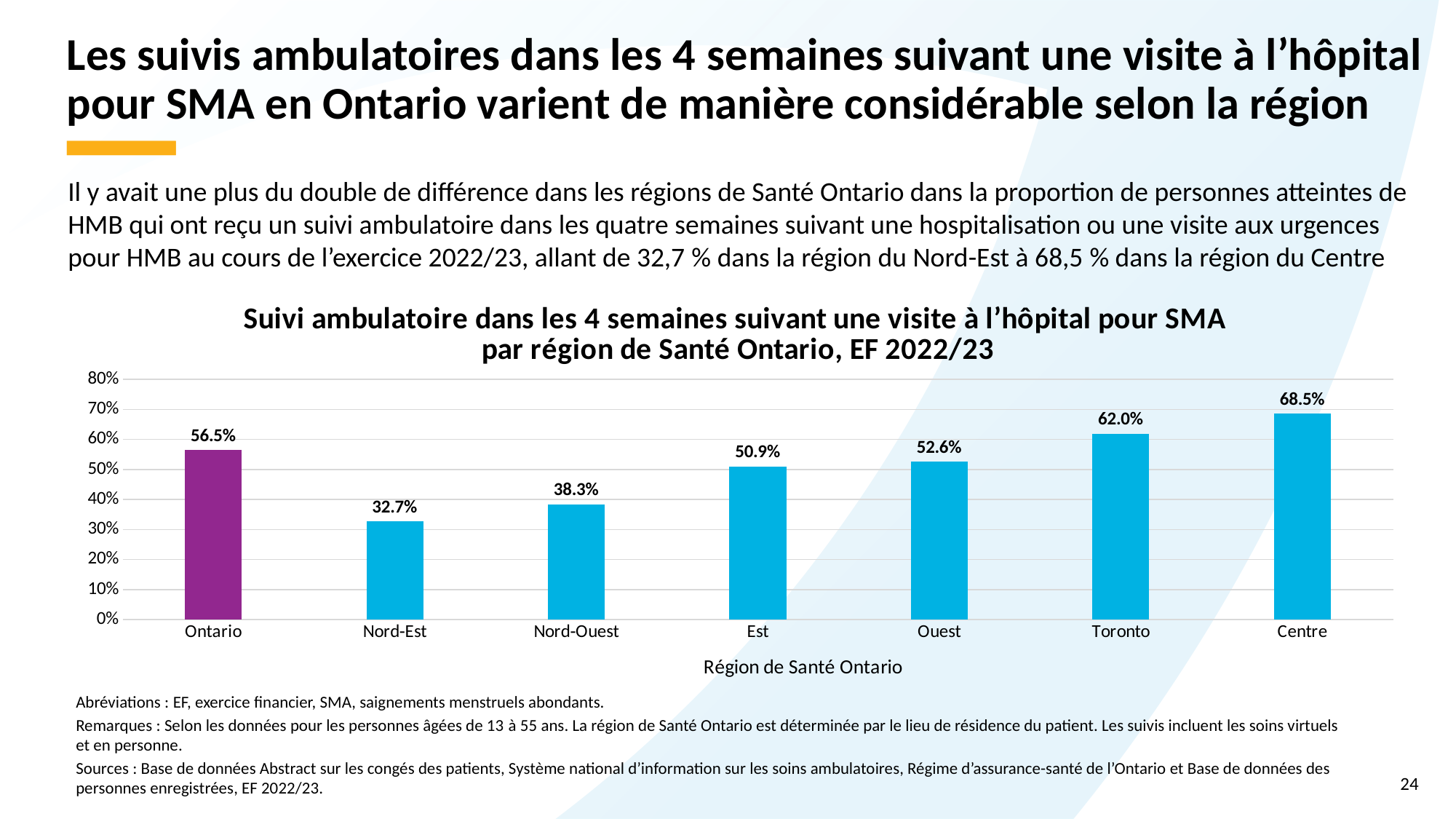
Which region has the lowest value? Nord-Est Which is larger, the value for Est or the value for Ouest? Ouest Which region has the highest value? Centre How many categories are shown on the x axis? 7 Is the value for Nord-Ouest greater or less than 40%? less What kind of chart is shown? bar chart What is the difference between the values for Centre and Nord-Est? 35.8% What is the x-axis title of the chart? Région de Santé Ontario Which bar is coloured differently (purple) from the others? Ontario What is the value for Toronto? 62.0% What is the value for Ontario? 56.5% What is the value for Nord-Est? 32.7%